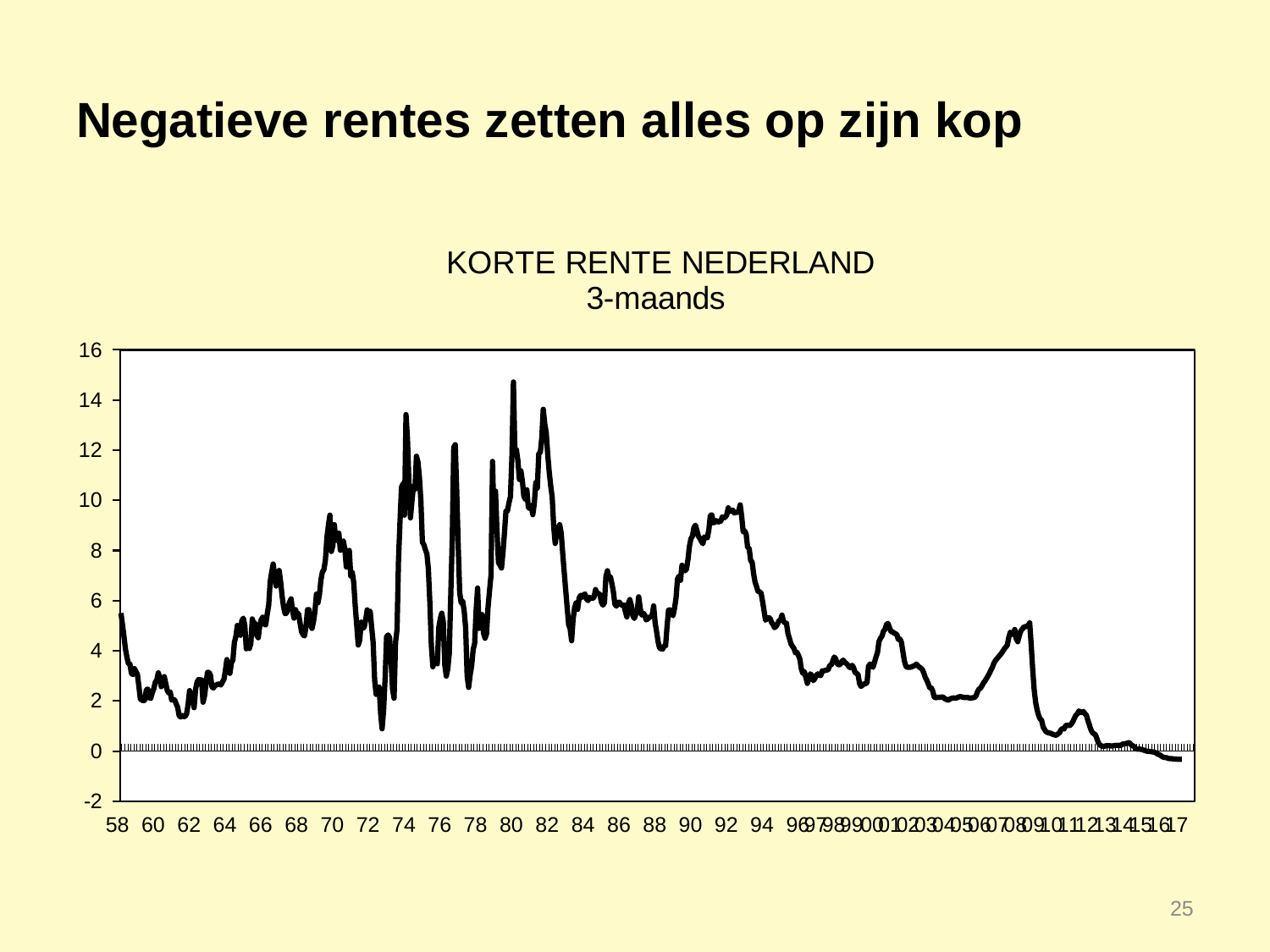
What is the lowest value shown on the y axis? -2 What subtitle appears under the chart title? 3-maands Does the line rise or fall between 08 and 17? fall Is the value at the start of the series (58) greater or less than 4? greater Is the value around 92 greater or less than 8? greater Does the line rise or fall between 88 and 92? rise Is the value at the end of the series (17) greater or less than 0? less What is the title of the chart? KORTE RENTE NEDERLAND What kind of chart is shown on the slide? line chart How many lines are plotted on the chart? 1 Around which year on the x axis does the line reach its highest value? 80